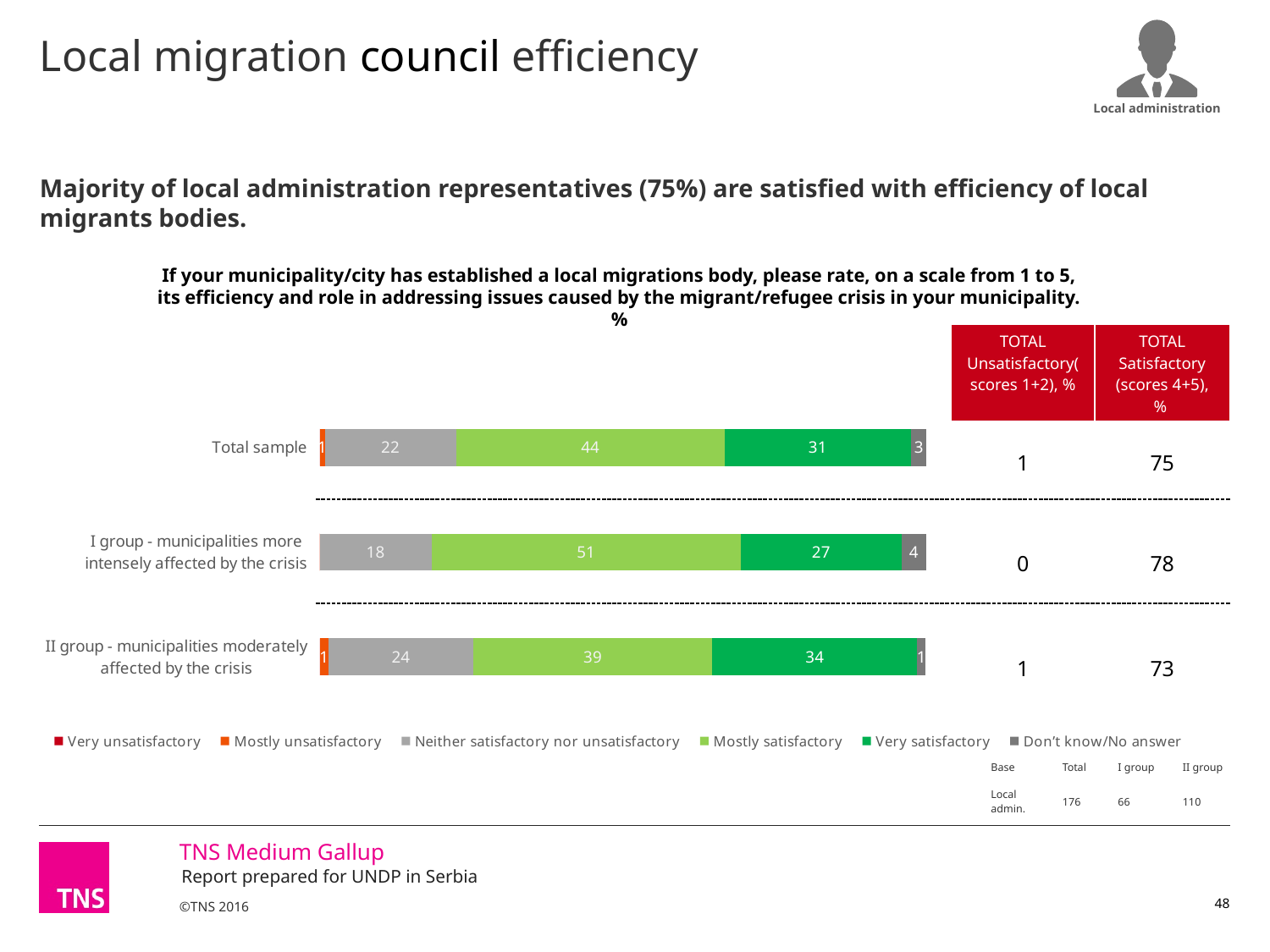
How many categories (groups) are plotted in the chart? 3 What is the TOTAL Satisfactory (scores 4+5) percentage shown for the I group? 78 What type of chart is shown on the slide? stacked bar chart What is the value for 'Very satisfactory' in the II group bar? 34 What is the value for 'Mostly satisfactory' in the Total sample bar? 44 What is the 'Don't know/No answer' value for the I group bar? 4 What is the value for 'Neither satisfactory nor unsatisfactory' in the I group bar? 18 Which group has the lowest value for 'Neither satisfactory nor unsatisfactory'? I group - municipalities more intensely affected by the crisis Which is larger: the 'Very satisfactory' value for the Total sample or for the I group? Total sample What is the difference between the 'Mostly satisfactory' values for the I group and the II group? 12 Which group has the highest value for 'Mostly satisfactory'? I group - municipalities more intensely affected by the crisis How many series does the chart legend list? 6